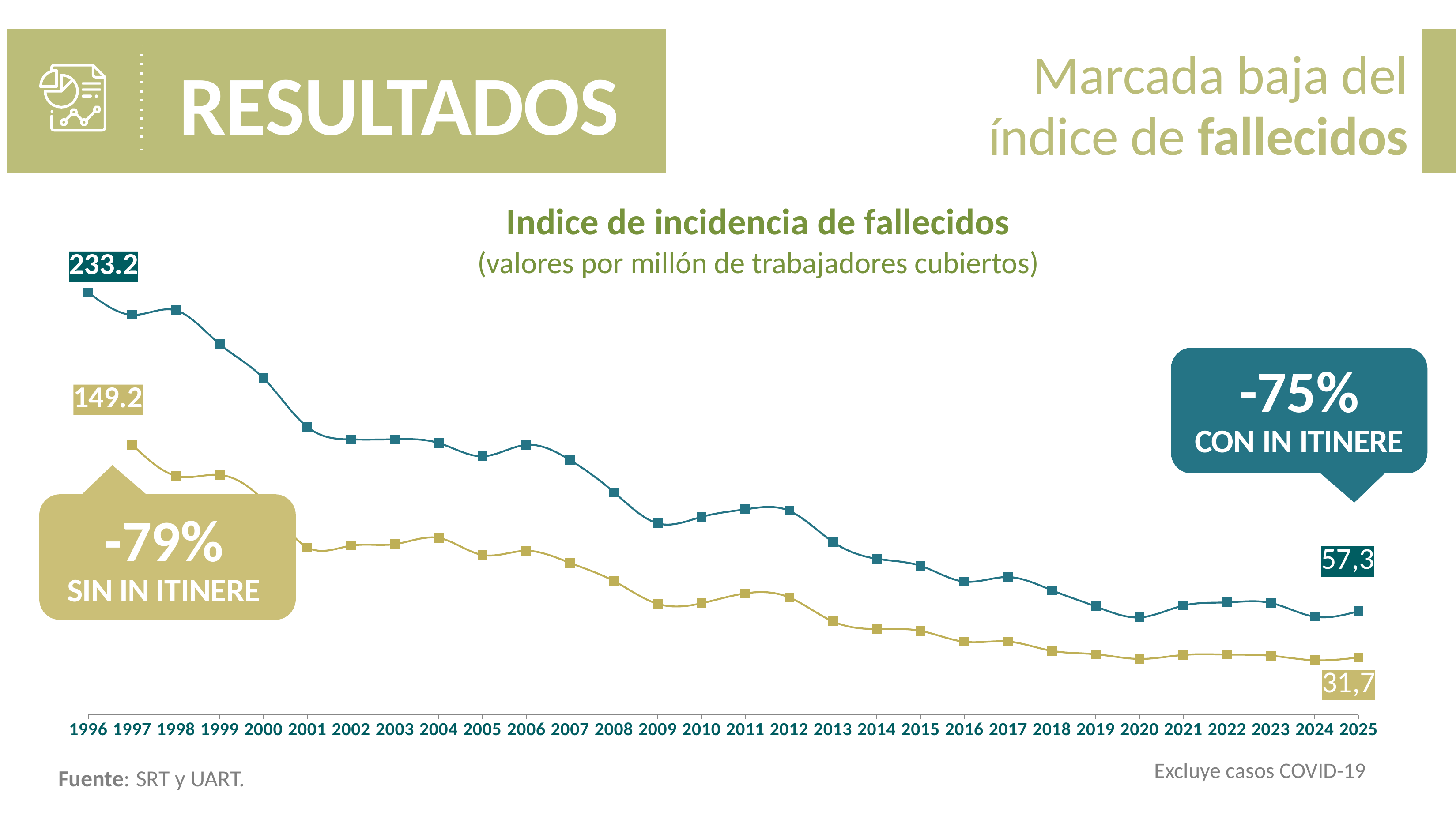
What kind of chart is shown on the slide? line chart What is the value of the CON IN ITINERE series in 2025? 57,3 Which series has the higher value in 2025, CON IN ITINERE or SIN IN ITINERE? CON IN ITINERE How many series are plotted in the chart? 2 What is the title of the chart? Indice de incidencia de fallecidos What is the value of the SIN IN ITINERE series in 2025? 31,7 What is the value of the CON IN ITINERE series in 1996? 233.2 Do the values of the CON IN ITINERE series rise or fall from 1996 to 2025? fall What percentage change is shown in the callout for the SIN IN ITINERE series? -79% How many years are shown on the x axis of the chart? 30